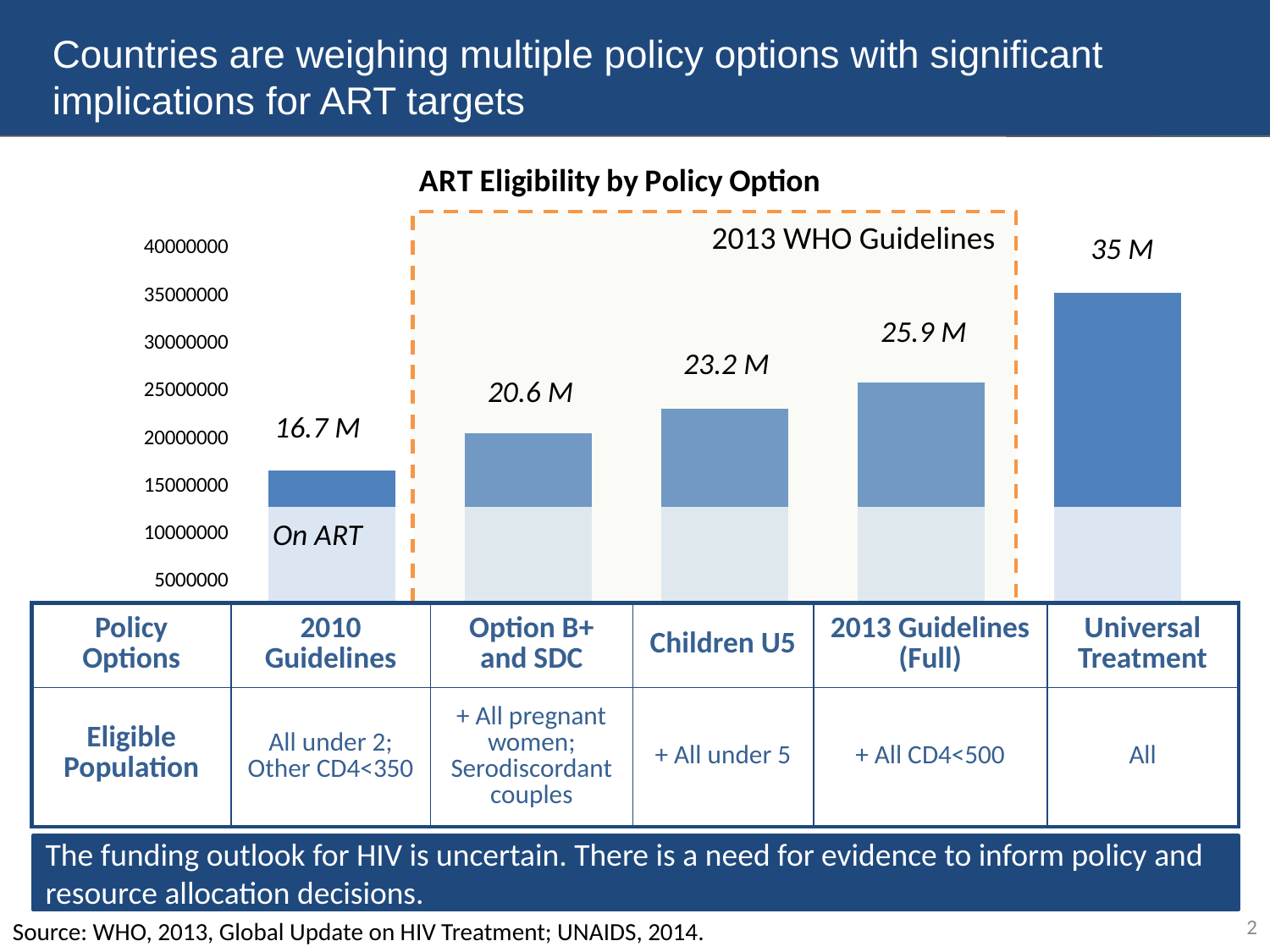
Which is larger, the value for Option B+ and SDC or the value for Children U5? Children U5 What is the value shown for the Option B+ and SDC bar? 20.6 M What is the value shown for the 2013 Guidelines (Full) bar? 25.9 M What is the title of the chart? ART Eligibility by Policy Option Which policy option has the lowest ART eligibility value? 2010 Guidelines How many policy options are plotted as bars in the chart? 5 What is the difference between the 2013 Guidelines (Full) value and the Children U5 value? 2.7 M What is the value shown for the Children U5 bar? 23.2 M Is the value for Universal Treatment greater or less than 30000000? greater What is the difference between the Universal Treatment value and the 2010 Guidelines value? 18.3 M What is the value shown for the 2010 Guidelines bar? 16.7 M Which policy option has the highest ART eligibility value? Universal Treatment